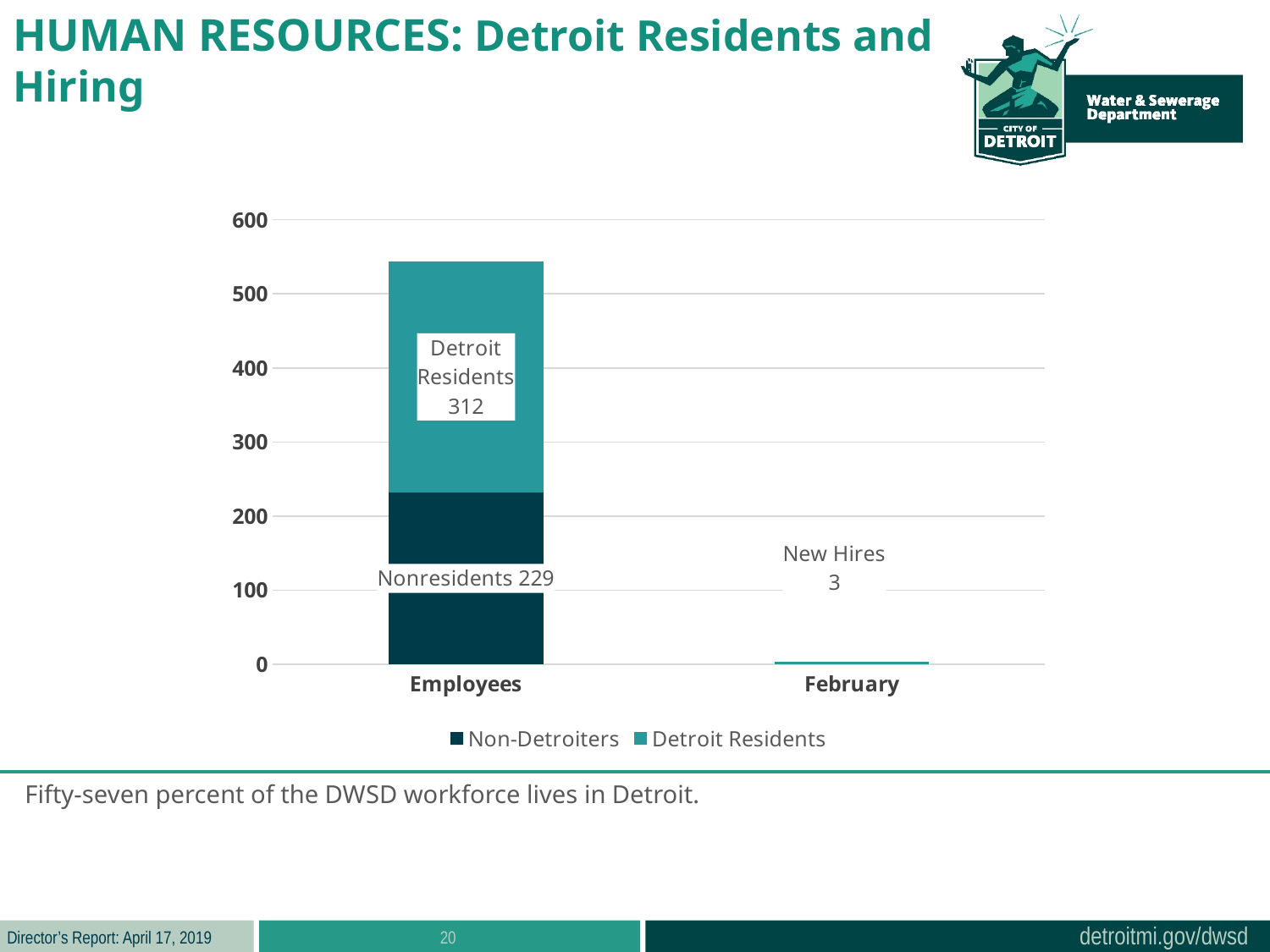
How many Nonresidents are shown in the Employees bar? 229 What is the difference between Detroit Residents and Nonresidents in the Employees bar? 83 What kind of chart is shown on the slide? stacked bar chart What is the value labelled New Hires for February? 3 How many series does the legend list? 2 How many categories are shown on the x axis? 2 How many Detroit Residents are shown in the Employees bar? 312 What are the two series names listed in the legend? Non-Detroiters and Detroit Residents Is the total Employees bar greater or less than 500? greater Which is larger in the Employees bar, Detroit Residents or Nonresidents? Detroit Residents Which category has the taller bar, Employees or February? Employees What is the total of the stacked Employees bar? 541